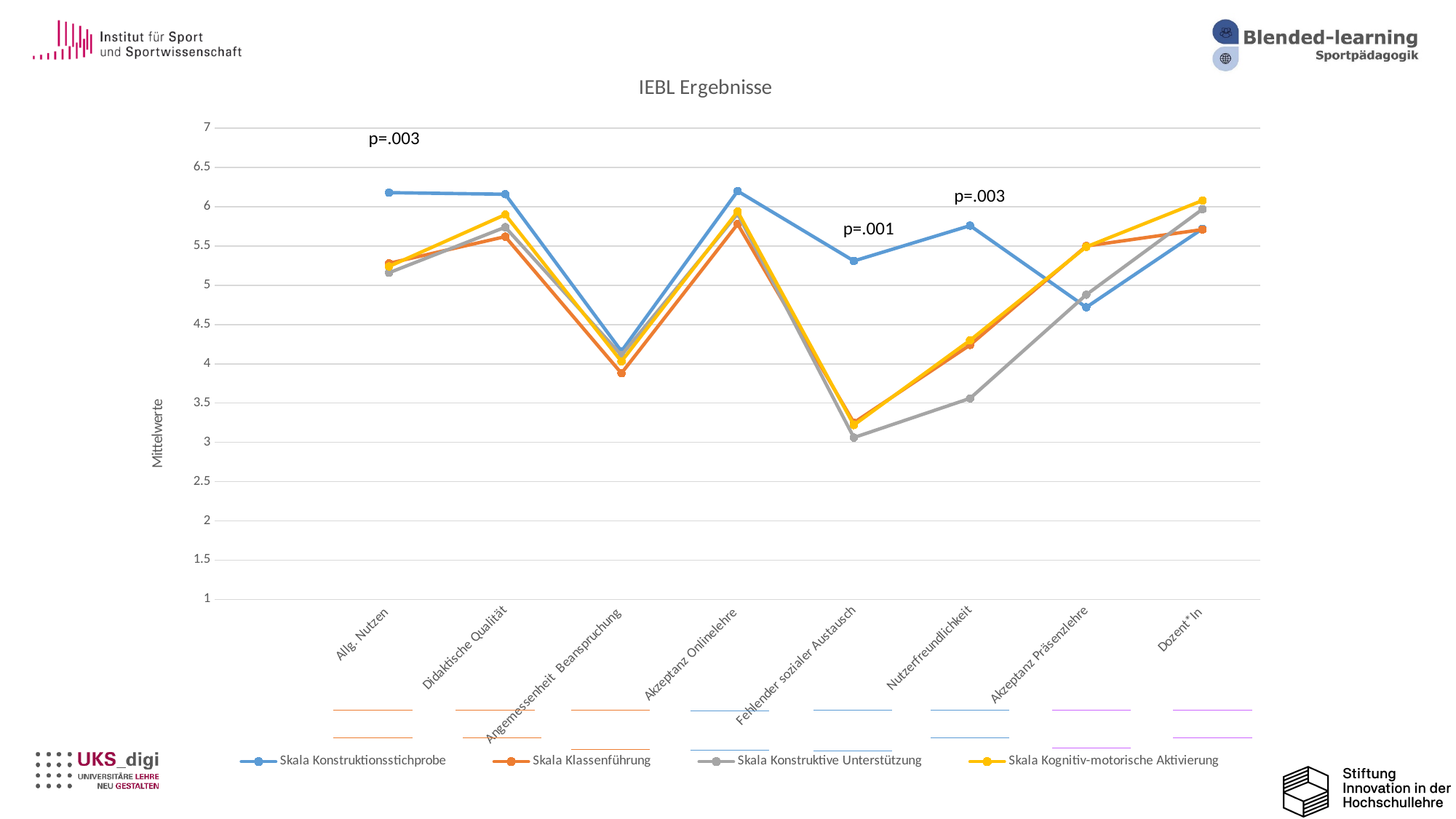
Is the value of Skala Konstruktive Unterstützung for Fehlender sozialer Austausch greater or less than 3.5? less For Dozent*In, which is larger: Skala Kognitiv-motorische Aktivierung or Skala Konstruktionsstichprobe? Skala Kognitiv-motorische Aktivierung For which category does Skala Konstruktionsstichprobe have its lowest value? Angemessenheit Beanspruchung What type of chart is shown on the slide? line chart How many categories are shown on the x axis? 8 For which category does Skala Kognitiv-motorische Aktivierung have its highest value? Dozent*In For which category does Skala Konstruktive Unterstützung have its lowest value? Fehlender sozialer Austausch What is the label of the y axis? Mittelwerte Is the value of Skala Konstruktionsstichprobe for Akzeptanz Präsenzlehre greater or less than 5? less How many series does the legend list? 4 For Nutzerfreundlichkeit, which is larger: Skala Konstruktionsstichprobe or Skala Konstruktive Unterstützung? Skala Konstruktionsstichprobe Is the value of Skala Konstruktionsstichprobe for Allg. Nutzen greater or less than 6? greater